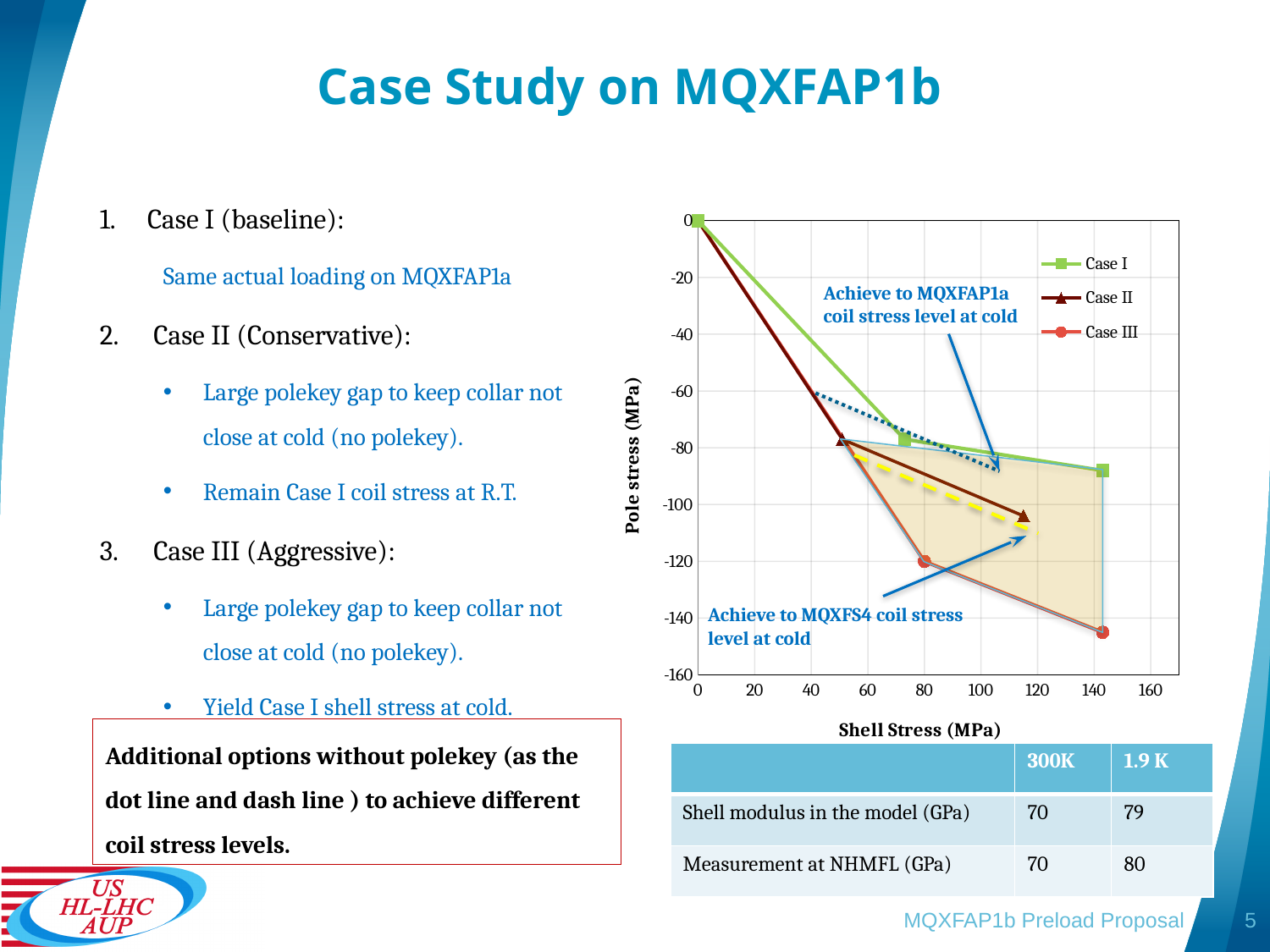
How many series does the chart legend list? 3 Is the final pole stress value for Case III greater or less than -140 MPa? less Which series ends at the highest (least negative) pole stress on the chart? Case I Is the final pole stress value for Case I greater or less than -100 MPa? greater What are the three series named in the chart legend? Case I, Case II, Case III Is the final pole stress value for Case II greater or less than -100 MPa? less What is the title of the chart's x axis? Shell Stress (MPa) At a shell stress of about 140 MPa, which series has the higher (less negative) pole stress, Case I or Case III? Case I As shell stress increases along the x axis, does the pole stress for Case I rise or fall? fall What type of chart is shown on the slide? line chart What is the maximum value shown on the chart's x axis? 160 Which series reaches the lowest (most negative) pole stress on the chart? Case III